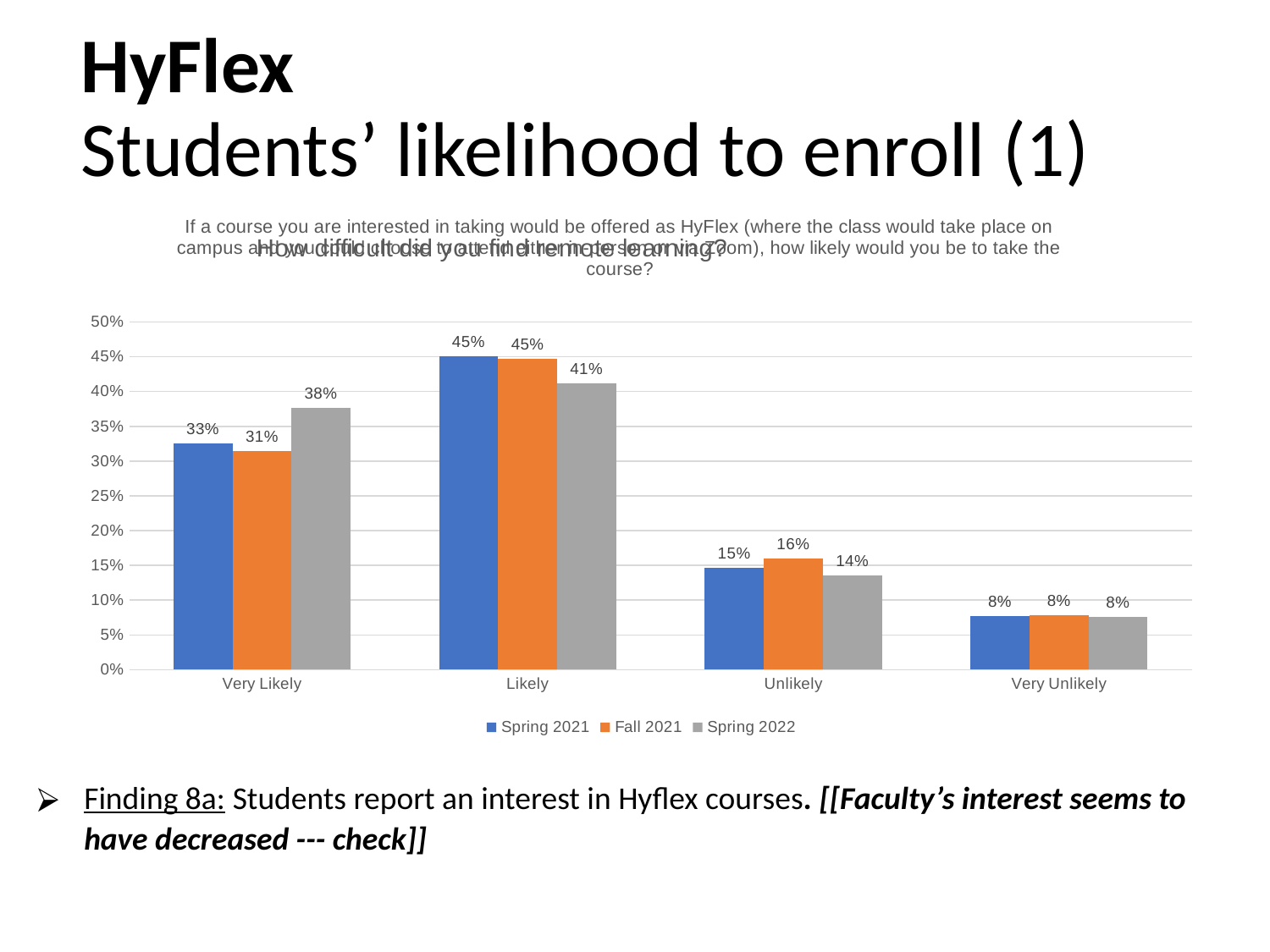
Which series is shown in orange in the legend? Fall 2021 How many series does the legend list? 3 How many categories are shown on the x axis? 4 What is the value for Fall 2021 in the Unlikely category? 16% What is the value for Spring 2022 in the Very Likely category? 38% What is the difference between the Spring 2022 and Fall 2021 values in the Very Likely category? 7% Which is larger in the Very Likely category: Spring 2021 or Fall 2021? Spring 2021 What kind of chart is shown on the slide? Bar chart What is the value for Spring 2021 in the Likely category? 45% Which category has the highest value for Spring 2022? Likely Which category has the lowest value for Spring 2021? Very Unlikely What is the difference between the Spring 2021 and Spring 2022 values in the Likely category? 4%